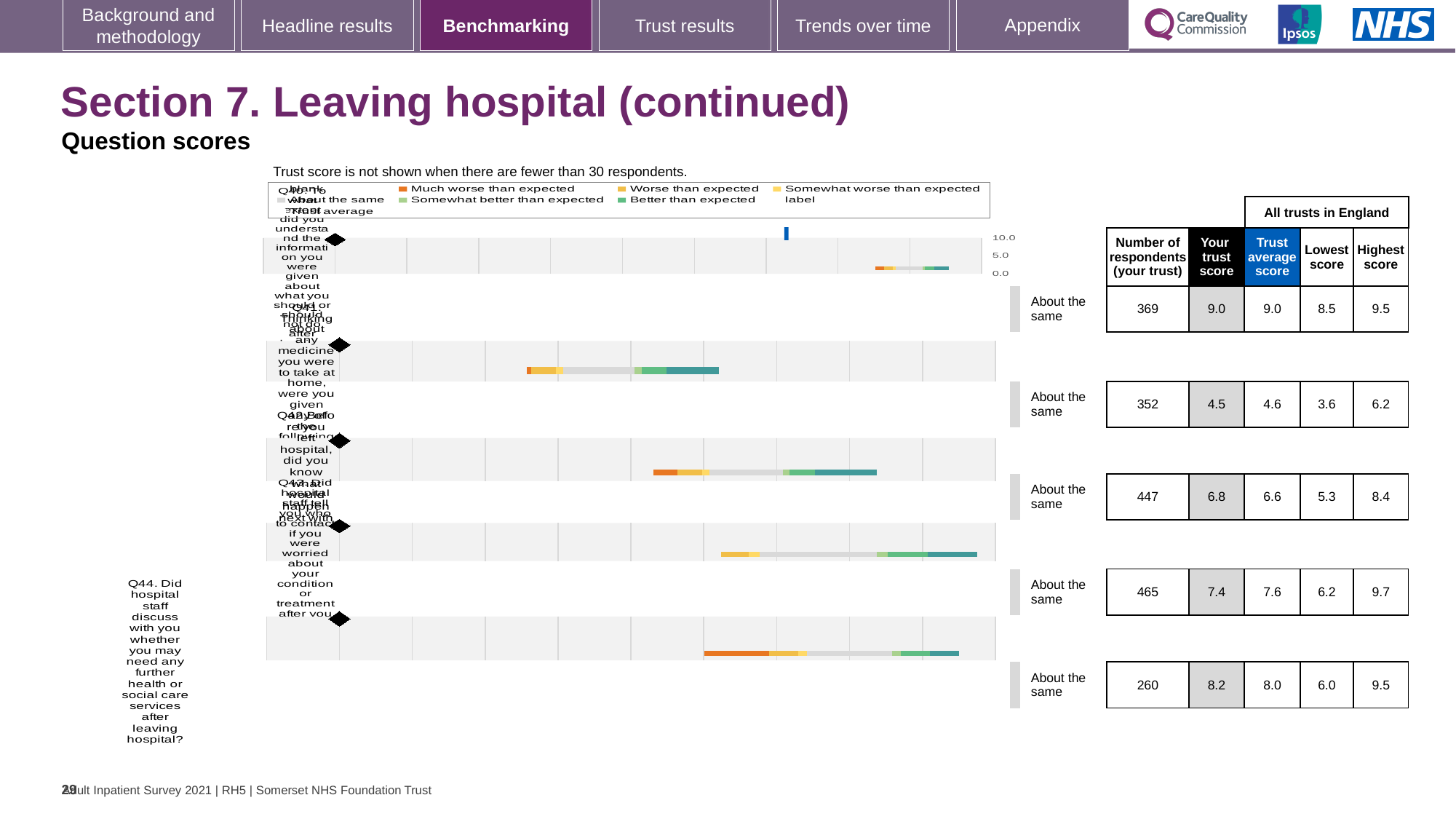
Is the trust score for Q44 greater or less than 5.0? greater What is the highest value shown on the chart's x axis? 10.0 What is the trust average score for Q44? 8.0 Which question row has the lowest trust score? The second row (4.5) How many question rows are plotted in the chart? 5 What benchmark category is shown for every question row in the chart? About the same What kind of chart is shown on the slide? bar chart Which question row has the highest number of respondents? The fourth row (465) How many respondents answered Q44 at this trust? 260 What is the trust score for Q44 (Did hospital staff discuss with you whether you may need any further health or social care services after leaving hospital?)? 8.2 What is the difference between the highest score and the lowest score for Q44? 3.5 For Q44, is the trust score or the trust average score larger? Trust score